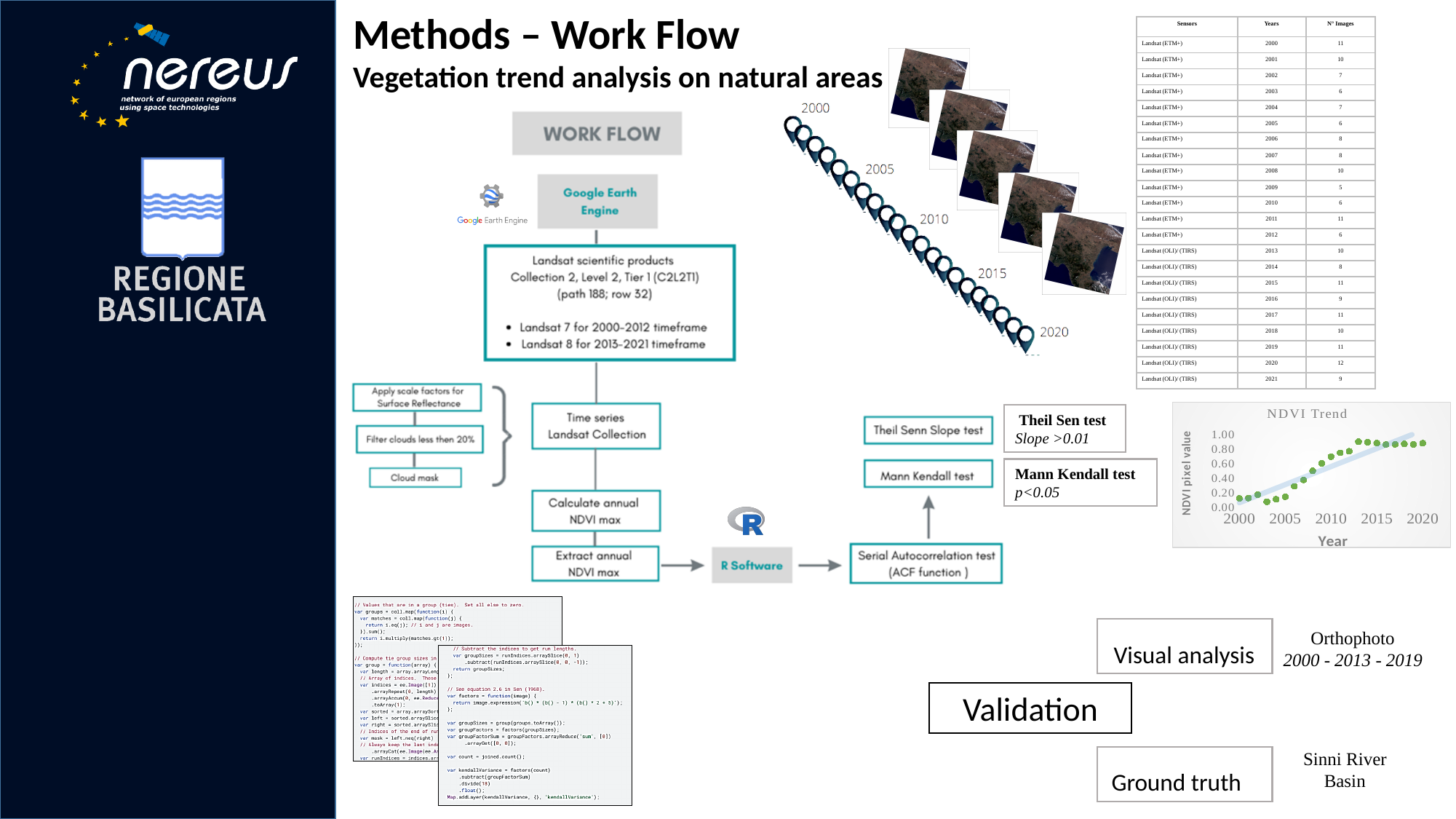
On the NDVI Trend chart, do the NDVI values rise or fall from 2000 to 2020? rise What is the title of the chart on the right side of the slide? NDVI Trend On the NDVI Trend chart, is the value for 2015 greater or less than 0.60? greater On the NDVI Trend chart, is the value for 2005 greater or less than 0.60? less On the NDVI Trend chart, is the value for 2000 greater or less than 0.40? less What is the label of the y axis on the NDVI Trend chart? NDVI pixel value On the NDVI Trend chart, which year has the larger NDVI value, 2000 or 2020? 2020 On the NDVI Trend chart, which year has the larger NDVI value, 2005 or 2015? 2015 What kind of chart is the NDVI Trend chart? scatter chart